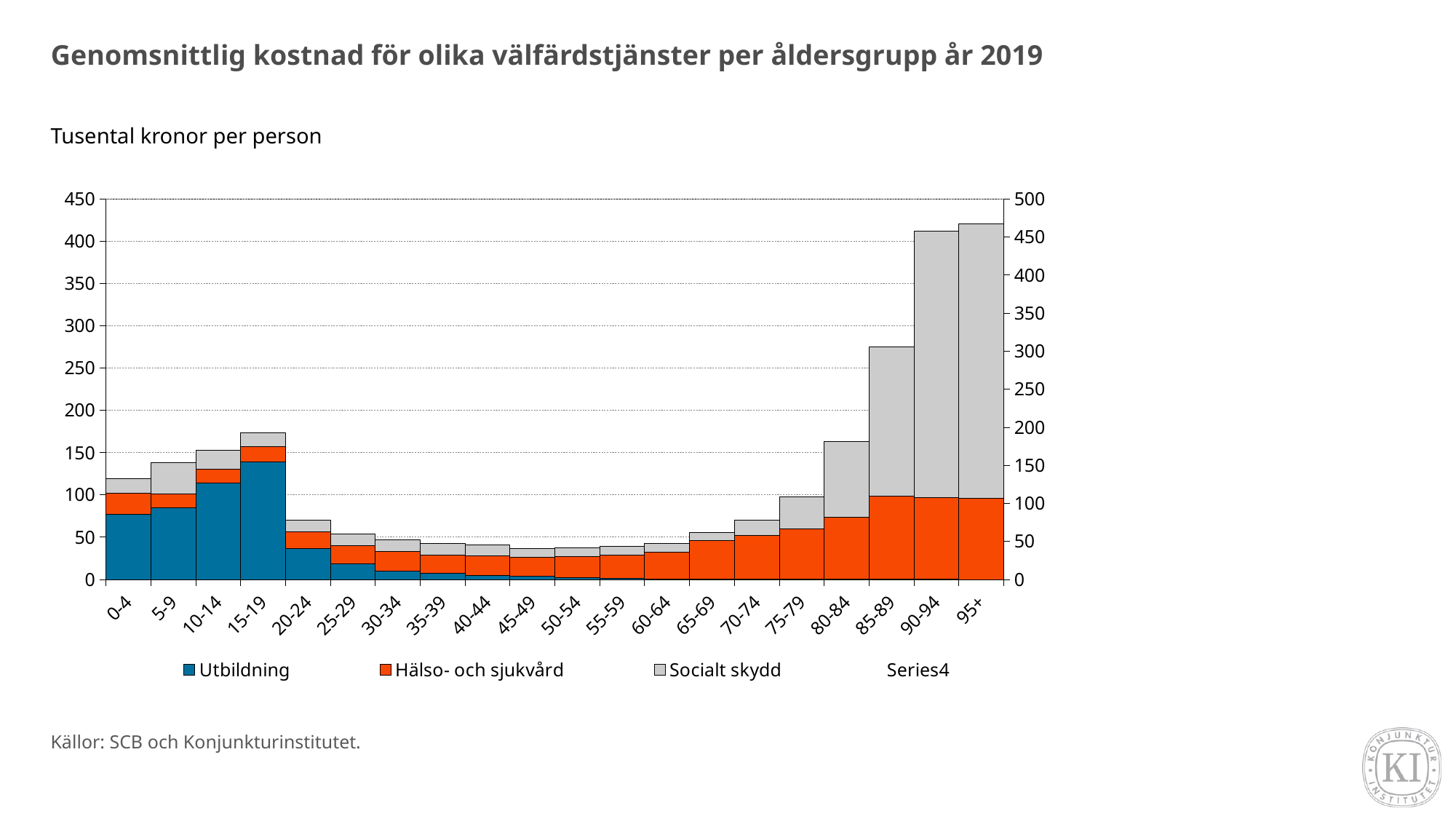
Which total bar is taller, 85-89 or 80-84? 85-89 Is the total bar for the 20-24 age group greater or less than 100? less Which colour represents Hälso- och sjukvård in the legend? Orange Is the total bar for the 85-89 age group greater or less than 250? greater Which age group has the largest Utbildning (blue) segment? 15-19 Which Utbildning segment is larger, 15-19 or 0-4? 15-19 What kind of chart is shown on the slide? Stacked bar chart Is the Utbildning segment for the 15-19 age group greater or less than 100? greater How many age groups are shown on the x axis? 20 What is the title of the chart? Genomsnittlig kostnad för olika välfärdstjänster per åldersgrupp år 2019 Do the total bars rise or fall from the 60-64 age group to the 95+ age group? rise How many entries does the legend list? 4